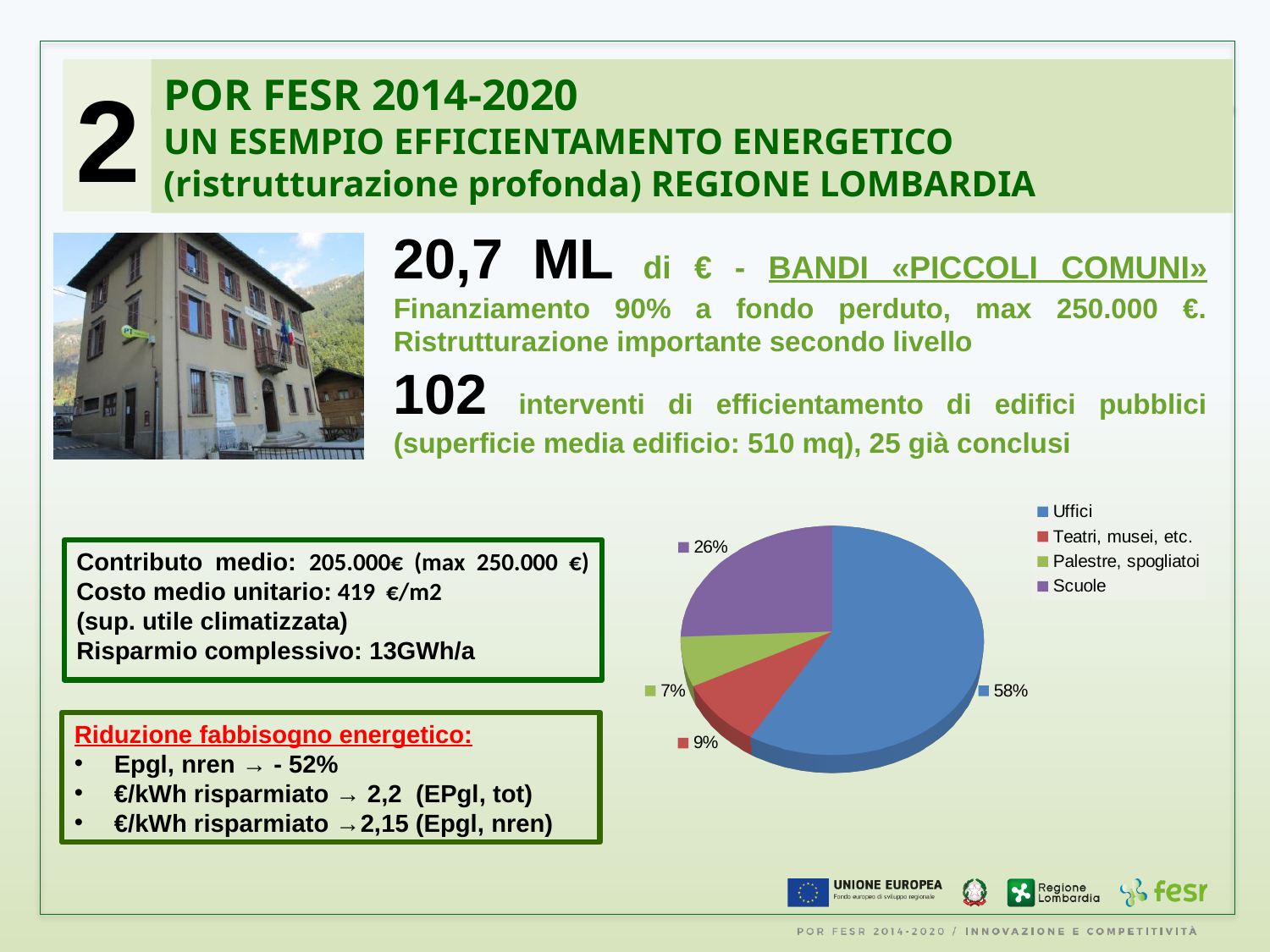
What share of the pie chart does Scuole represent? 26% What is the difference in percentage points between the Uffici slice and the Scuole slice? 32 What colour is the Scuole slice in the pie chart? purple Which slice is larger, Teatri, musei, etc. or Palestre, spogliatoi? Teatri, musei, etc. What share of the pie chart does Teatri, musei, etc. represent? 9% What is the combined share of the Teatri, musei, etc. and Palestre, spogliatoi slices? 16% Which category has the smallest slice of the pie chart? Palestre, spogliatoi How many categories does the pie chart show? 4 What kind of chart is shown on the slide? pie chart What share of the pie chart does Uffici represent? 58% Which category has the largest slice of the pie chart? Uffici What share of the pie chart does Palestre, spogliatoi represent? 7%